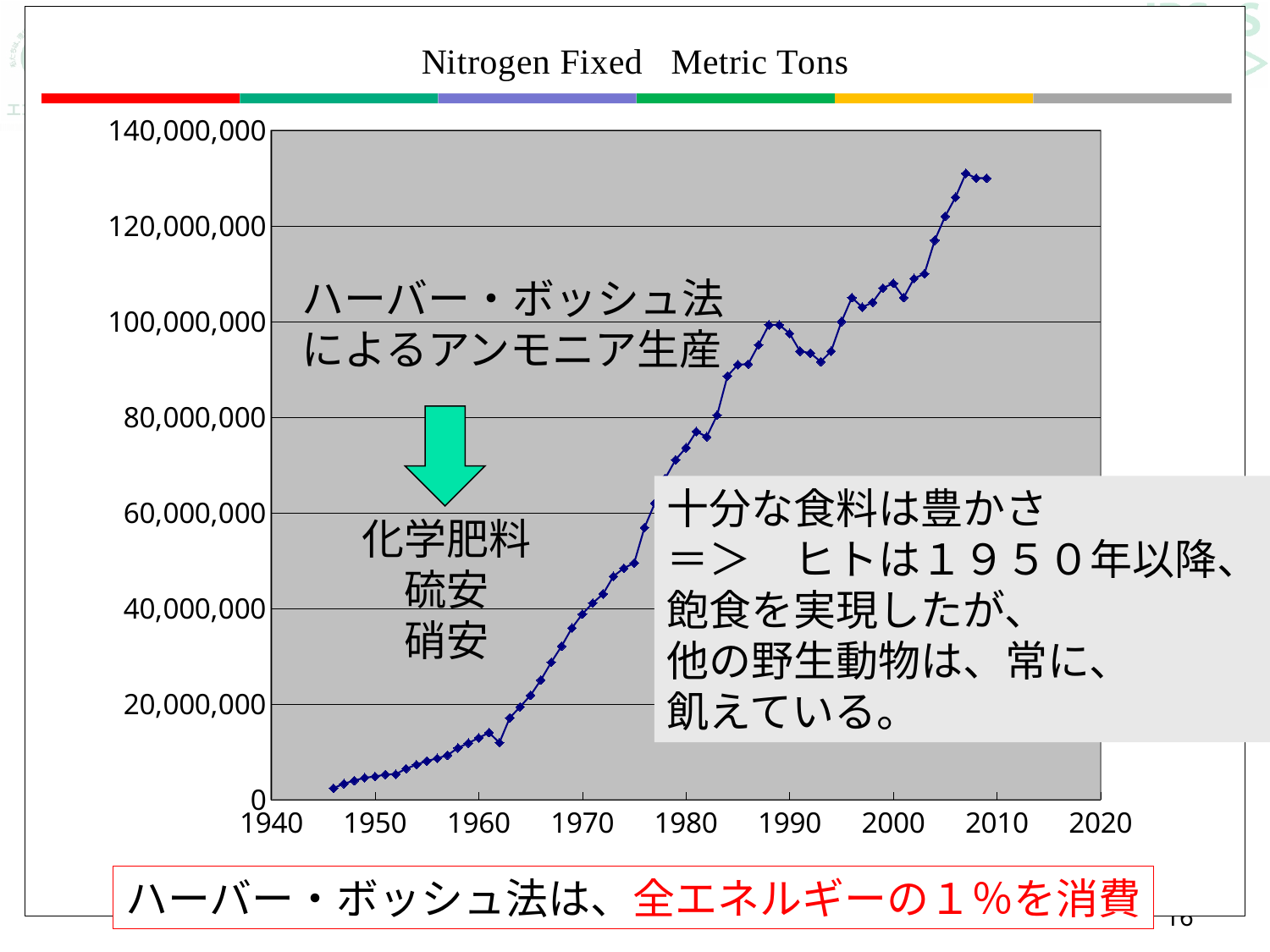
Between about 1989 and 1993, does the line rise or fall? fall What is the highest value shown on the y axis? 140,000,000 What is the title of the chart? Nitrogen Fixed Metric Tons What kind of chart is shown on the slide? line chart Is the value for 1950 greater or less than 20,000,000? less Overall, does the plotted value rise or fall from 1946 to 2009? rise Is the highest value on the chart greater or less than 120,000,000? greater Is the value for 1960 greater or less than 20,000,000? less How many data series are plotted on the chart? 1 Which is larger, the value for 1970 or the value for 1990? 1990